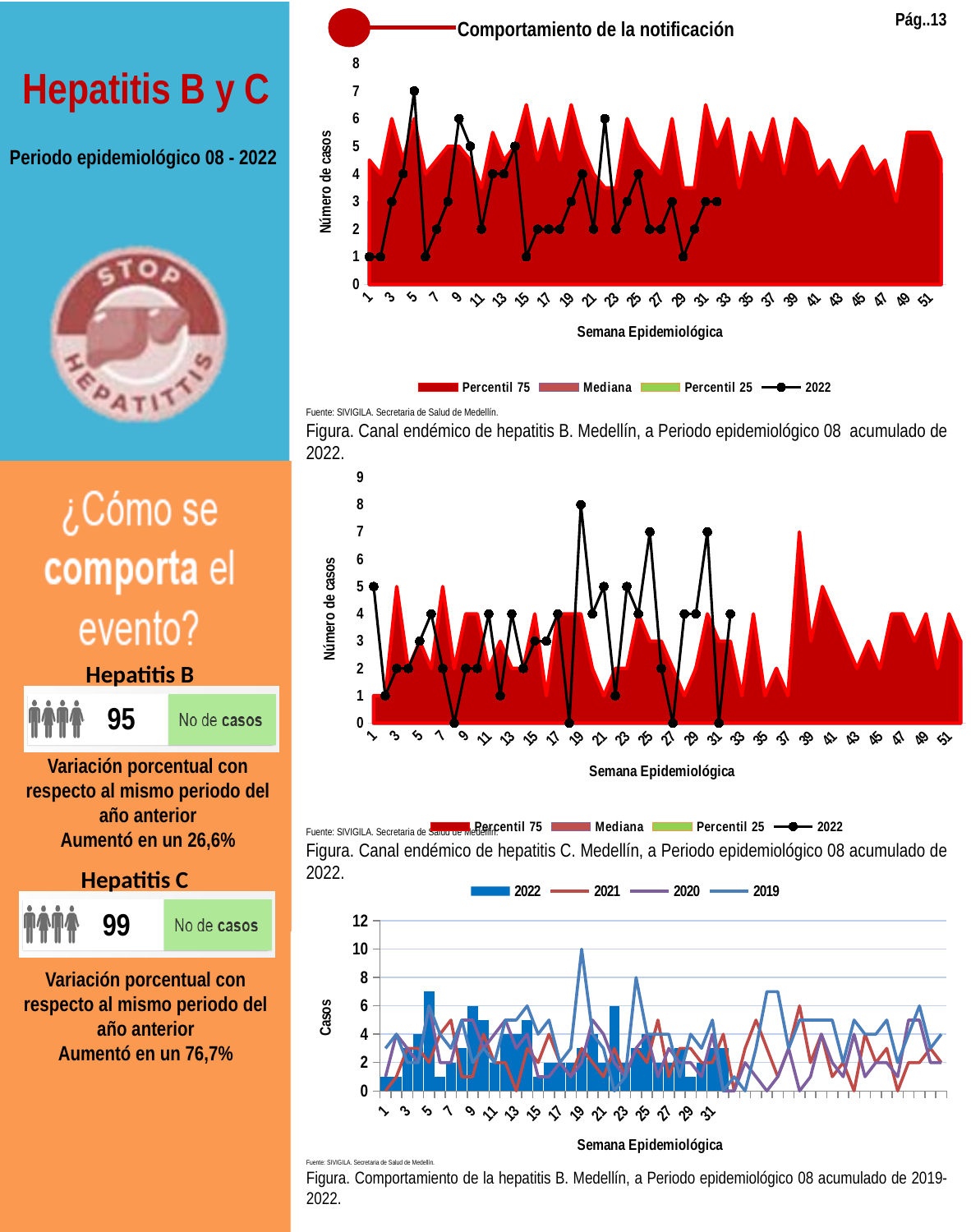
In the middle chart (Canal endémico de hepatitis C), is the 2022 value at week 19 greater or less than 7? greater In the top chart (Canal endémico de hepatitis B), what is the value of the 2022 line at week 5? 7 In the top chart (Canal endémico de hepatitis B), how many series does the legend list? 4 In the middle chart (Canal endémico de hepatitis C), what is the value of the 2022 line at week 19? 8 In the middle chart (Canal endémico de hepatitis C), at which epidemiological week does the 2022 line reach its highest value? Week 19 In the bottom chart (Comportamiento de la hepatitis B 2019-2022), how many series does the legend list? 4 In the bottom chart (Comportamiento de la hepatitis B 2019-2022), is the 2019 value at week 19 greater or less than 8? greater In the top chart (Canal endémico de hepatitis B), is the 2022 value at week 5 greater or less than 6? greater In the bottom chart (Comportamiento de la hepatitis B 2019-2022), which series is drawn as bars? 2022 In the top chart (Canal endémico de hepatitis B), at which epidemiological week does the 2022 line reach its highest value? Week 5 What is the x-axis title of the bottom chart (Comportamiento de la hepatitis B 2019-2022)? Semana Epidemiológica In the bottom chart (Comportamiento de la hepatitis B 2019-2022), which series reaches the highest value on the chart? 2019